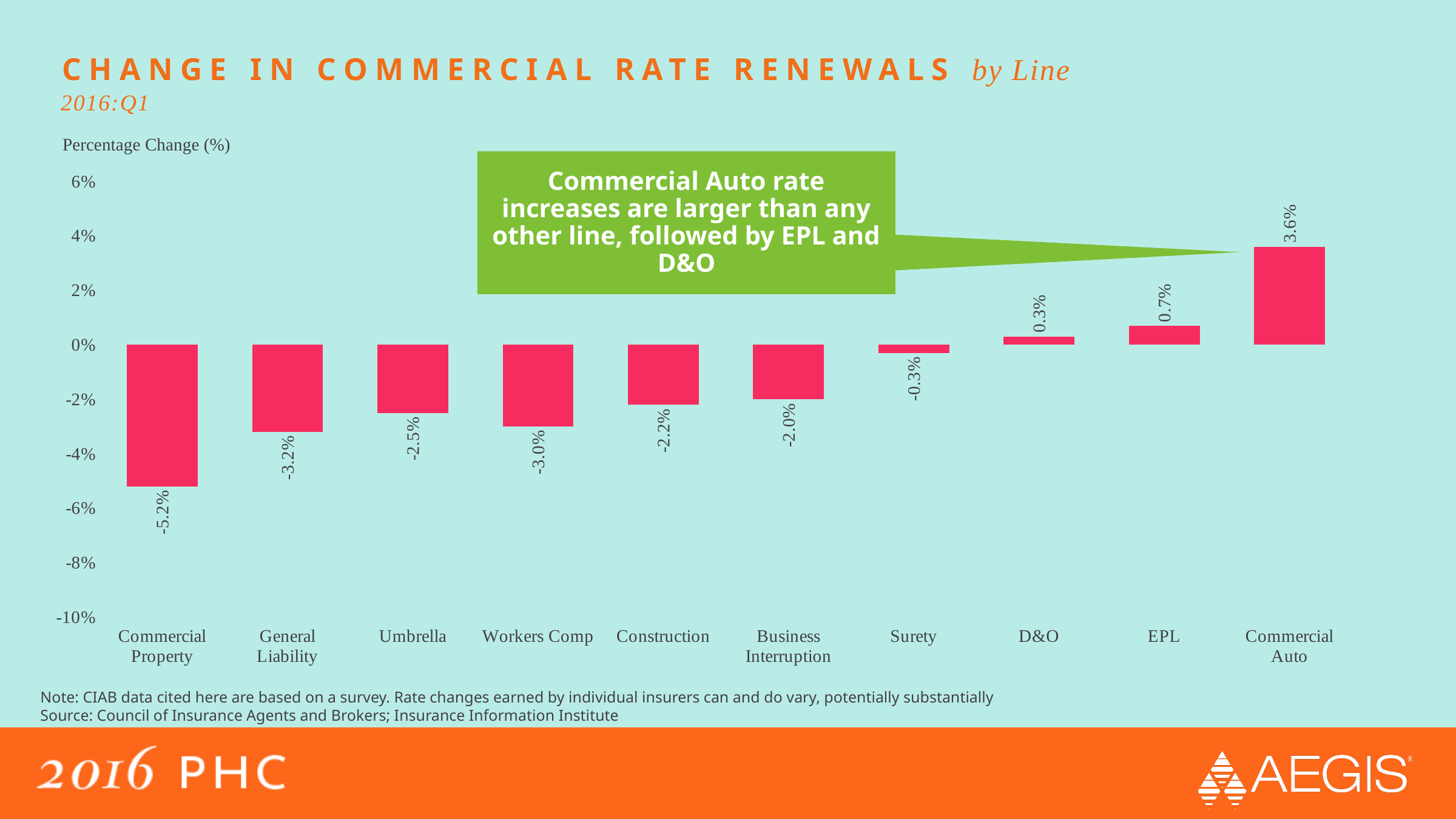
Is the value for General Liability greater or less than -2%? less What is the percentage change for Workers Comp? -3.0% What is the percentage change for Commercial Auto? 3.6% What is the percentage change for Commercial Property? -5.2% Which line has the lowest percentage change? Commercial Property What is the difference between the percentage change for Commercial Auto and EPL? 2.9% Which has a larger percentage change, D&O or EPL? EPL What kind of chart is shown on the slide? Bar chart Which line has the highest percentage change? Commercial Auto How many lines are shown on the chart? 10 What is the label of the vertical axis? Percentage Change (%) What is the percentage change for EPL? 0.7%